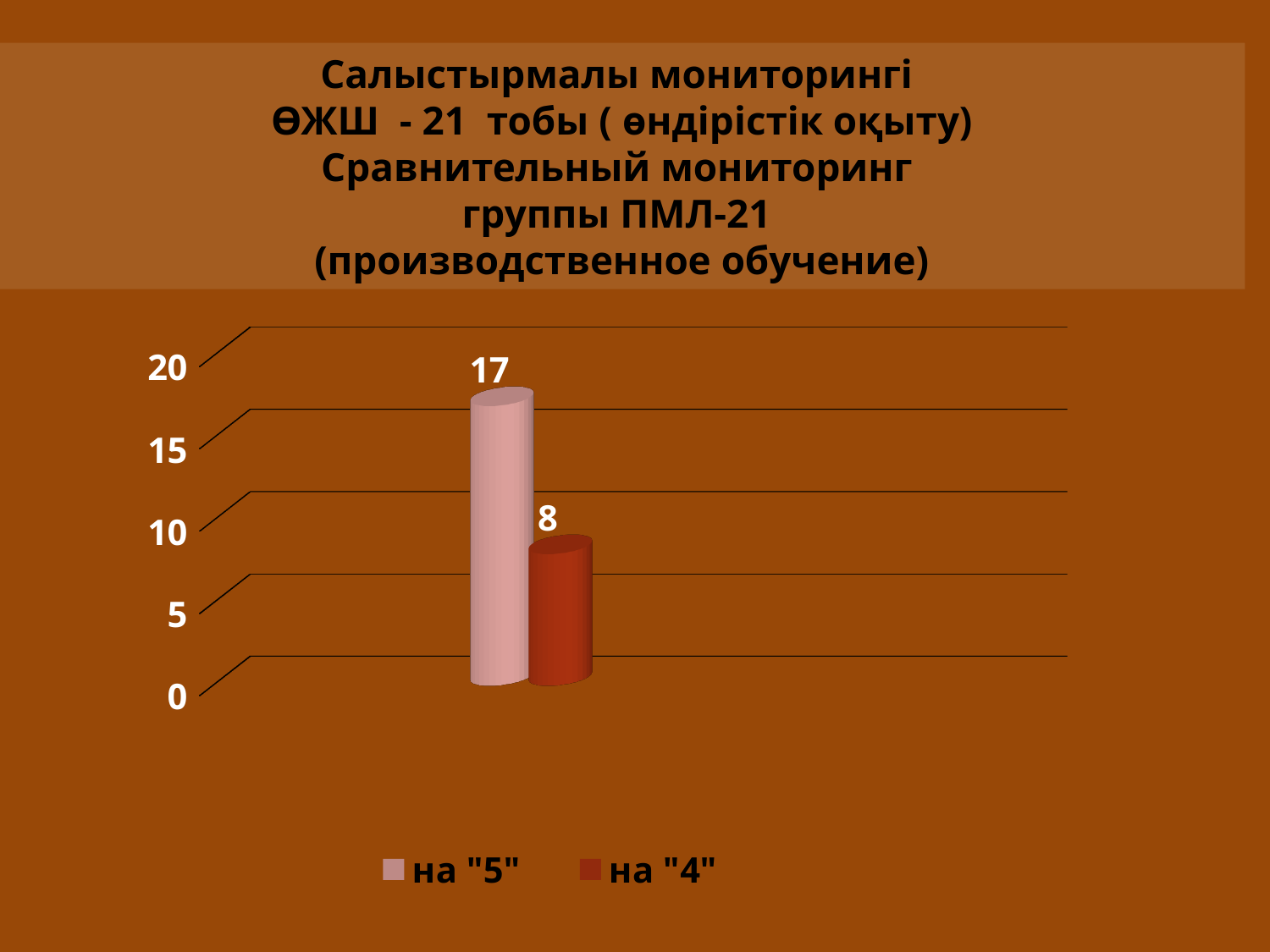
What is the difference between the values for на "5" and на "4"? 9 Is the value for на "4" greater or less than 10? less Is the value for на "5" greater or less than 15? greater Which is larger, the value for на "5" or the value for на "4"? на "5" Which series has the lowest value? на "4" What colour is the bar for на "4"? dark red What is the maximum value shown on the vertical axis? 20 What is the value for на "4"? 8 What kind of chart is shown on the slide? bar chart What is the value for на "5"? 17 How many series does the legend list? 2 Which series has the highest value? на "5"